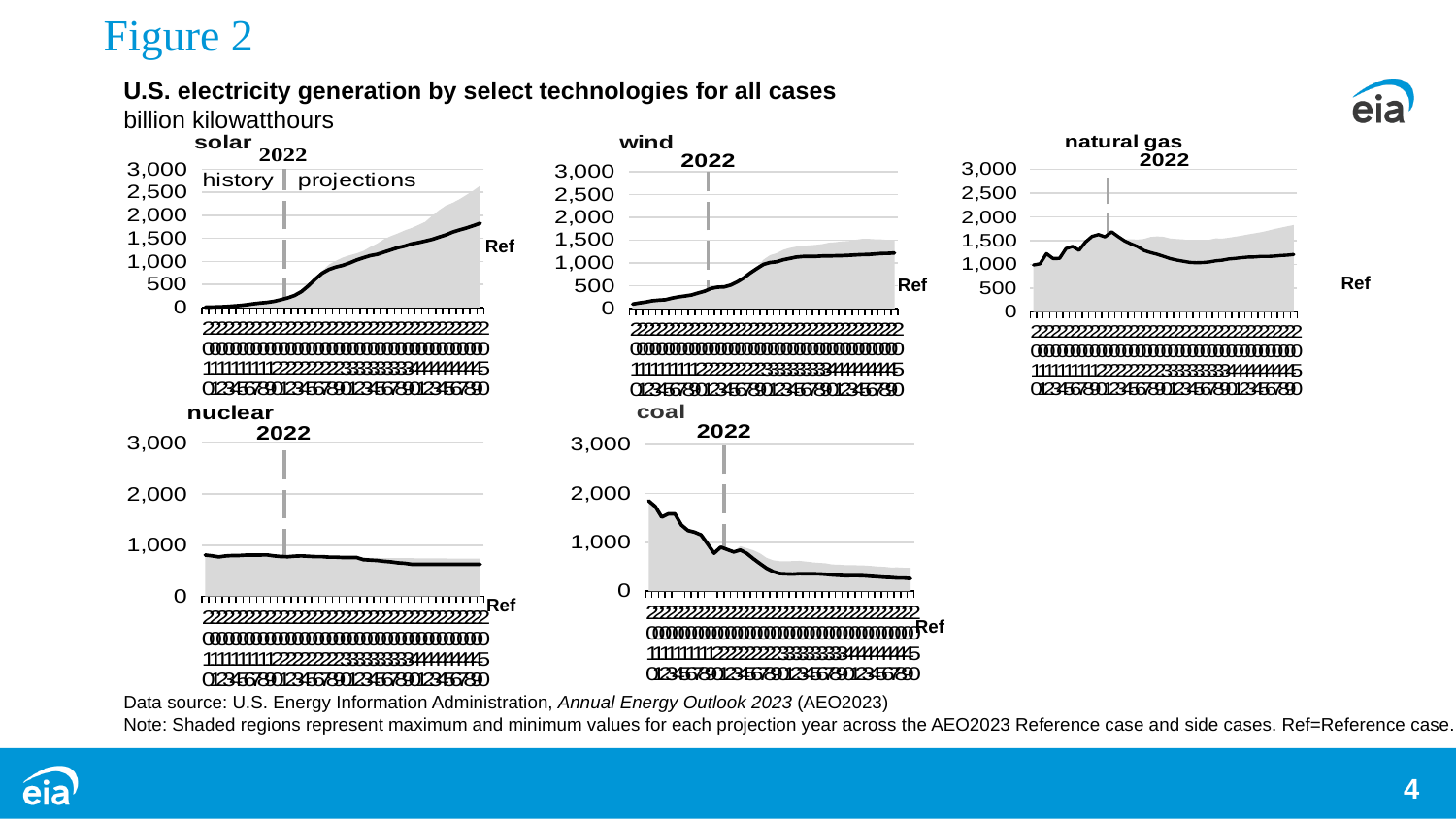
In the coal chart, does the Ref line rise or fall along the x axis? fall In the wind chart, is the Ref value at the end of the projection period greater or less than 1,500? less In the natural gas chart, is the Ref value at the end of the projection period greater or less than 1,000? greater In the nuclear chart, is the Ref value at the end of the projection period greater or less than 1,000? less In the solar chart, does the Ref line rise or fall over the projection period? rise What is the overall title of the figure on the slide? U.S. electricity generation by select technologies for all cases What kind of chart is the solar chart? line chart with a shaded area In what unit are the values on the charts expressed? billion kilowatthours How many separate charts are shown on the slide? 5 In the wind chart, does the Ref line rise or fall from the start of the series to the end? rise